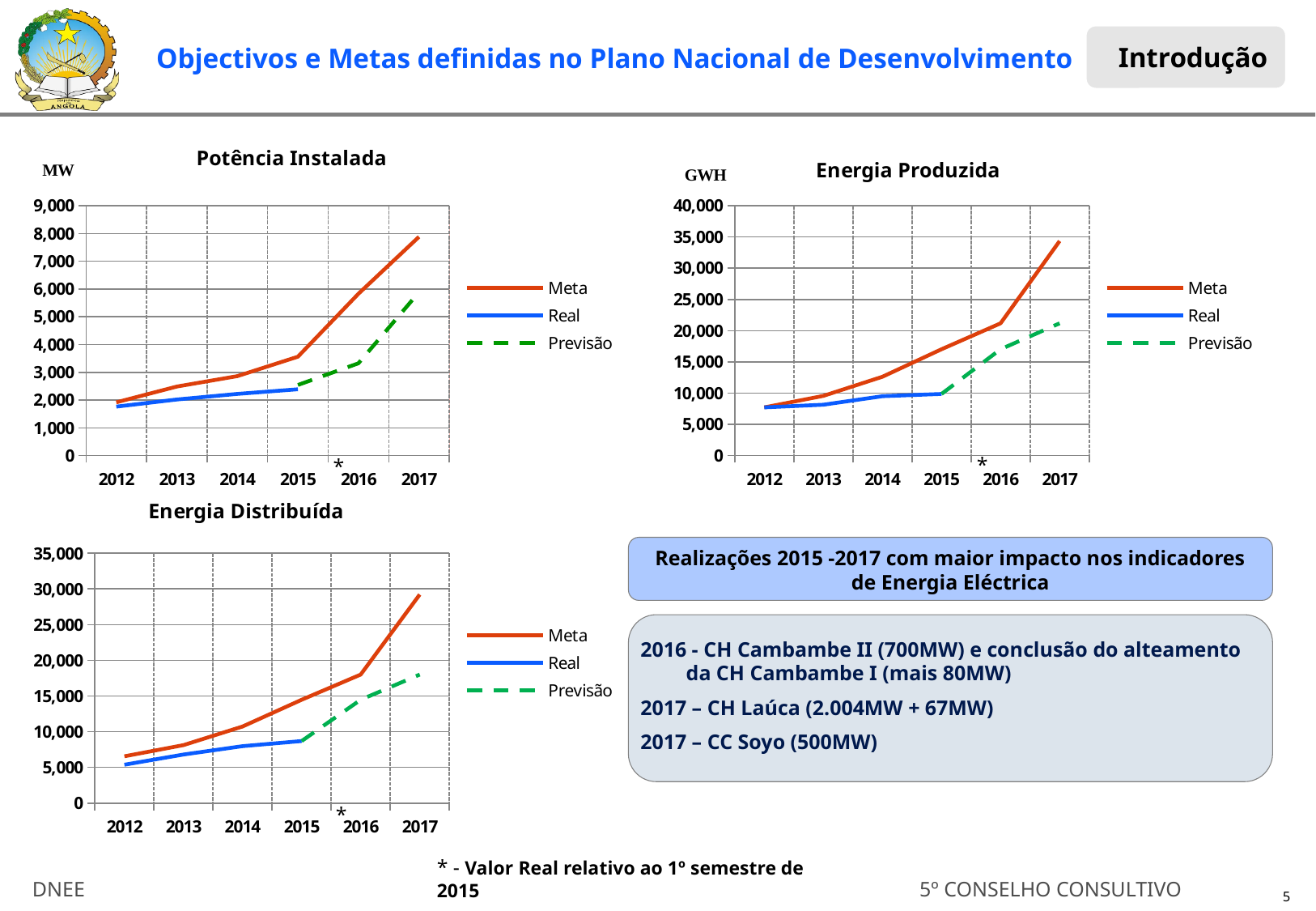
What kind of chart is the 'Potência Instalada' chart? line chart How many years are shown on the x axis of the 'Energia Distribuída' chart? 6 In the 'Energia Distribuída' chart, is the Meta value for 2017 greater or less than 25,000? greater In the 'Potência Instalada' chart, is the Real value for 2012 greater or less than 2,000? less In the 'Energia Distribuída' chart, is the Previsão value for 2017 greater or less than 20,000? less In the 'Potência Instalada' chart, does the Meta series rise or fall from 2012 to 2017? rise How many series does the legend of the 'Energia Produzida' chart list? 3 In the 'Energia Distribuída' chart, which series has the larger value in 2017, Meta or Previsão? Meta What unit is shown on the y axis of the 'Energia Produzida' chart? GWH